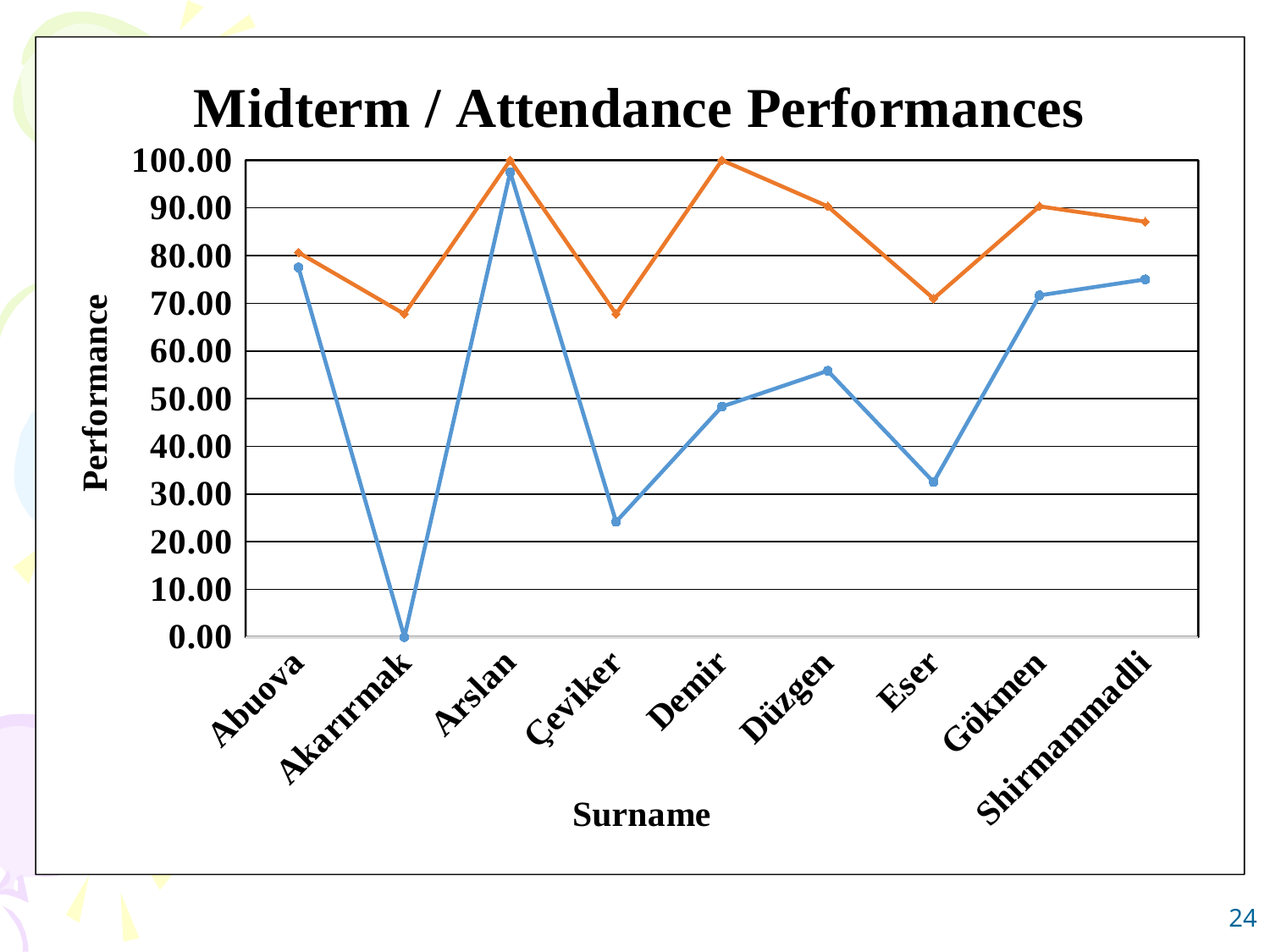
On the blue line, which is larger, the value for Demir or the value for Düzgen? Düzgen Which surname has the lowest value on the blue line? Akarırmak On the orange line, which is larger, the value for Demir or the value for Eser? Demir What is the value of the blue line for Akarırmak? 0.00 What is the title of the chart? Midterm / Attendance Performances Is the value of the blue line for Düzgen greater or less than 50.00? greater Is the value of the orange line for Shirmammadli greater or less than 80.00? greater What kind of chart is shown on the slide? line chart How many surnames are plotted along the x axis? 9 Is the value of the blue line for Çeviker greater or less than 30.00? less Which surname has the highest value on the blue line? Arslan What is the label of the vertical axis? Performance